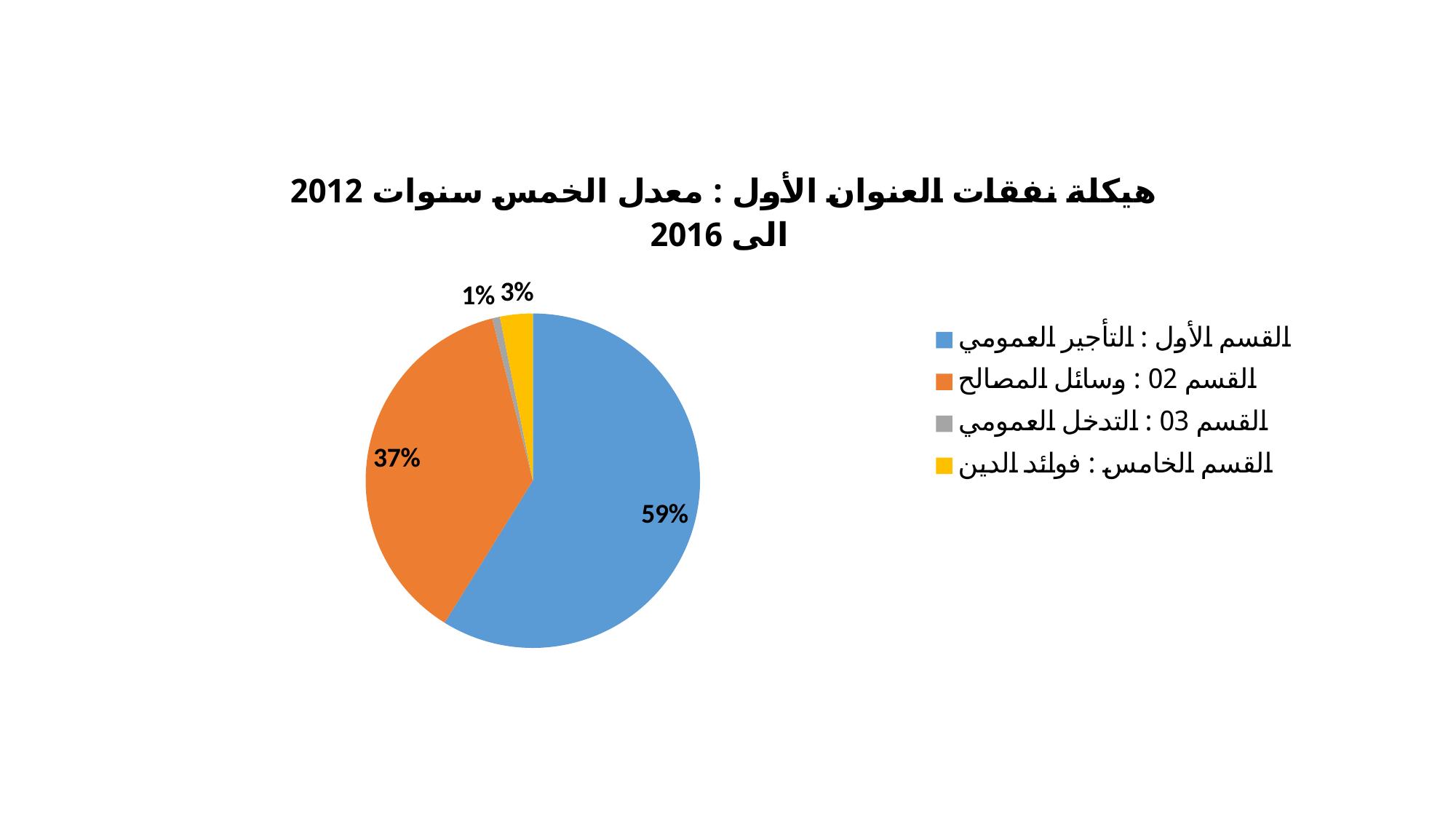
What share of the pie does القسم الخامس : فوائد الدين have? 3% What is the title of the chart? هيكلة نفقات العنوان الأول : معدل الخمس سنوات 2012 الى 2016 What share of the pie does القسم 02 : وسائل المصالح have? 37% Which category has the largest slice of the pie? القسم الأول : التأجير العمومي What share of the pie does القسم 03 : التدخل العمومي have? 1% What is the difference in percentage points between القسم الأول : التأجير العمومي and القسم 02 : وسائل المصالح? 22% What kind of chart is shown on the slide? Pie chart What colour is the slice for القسم 02 : وسائل المصالح? Orange Which is larger, the slice for القسم الخامس : فوائد الدين or the slice for القسم 03 : التدخل العمومي? القسم الخامس : فوائد الدين How many categories does the pie chart have? 4 Which category has the smallest slice of the pie? القسم 03 : التدخل العمومي